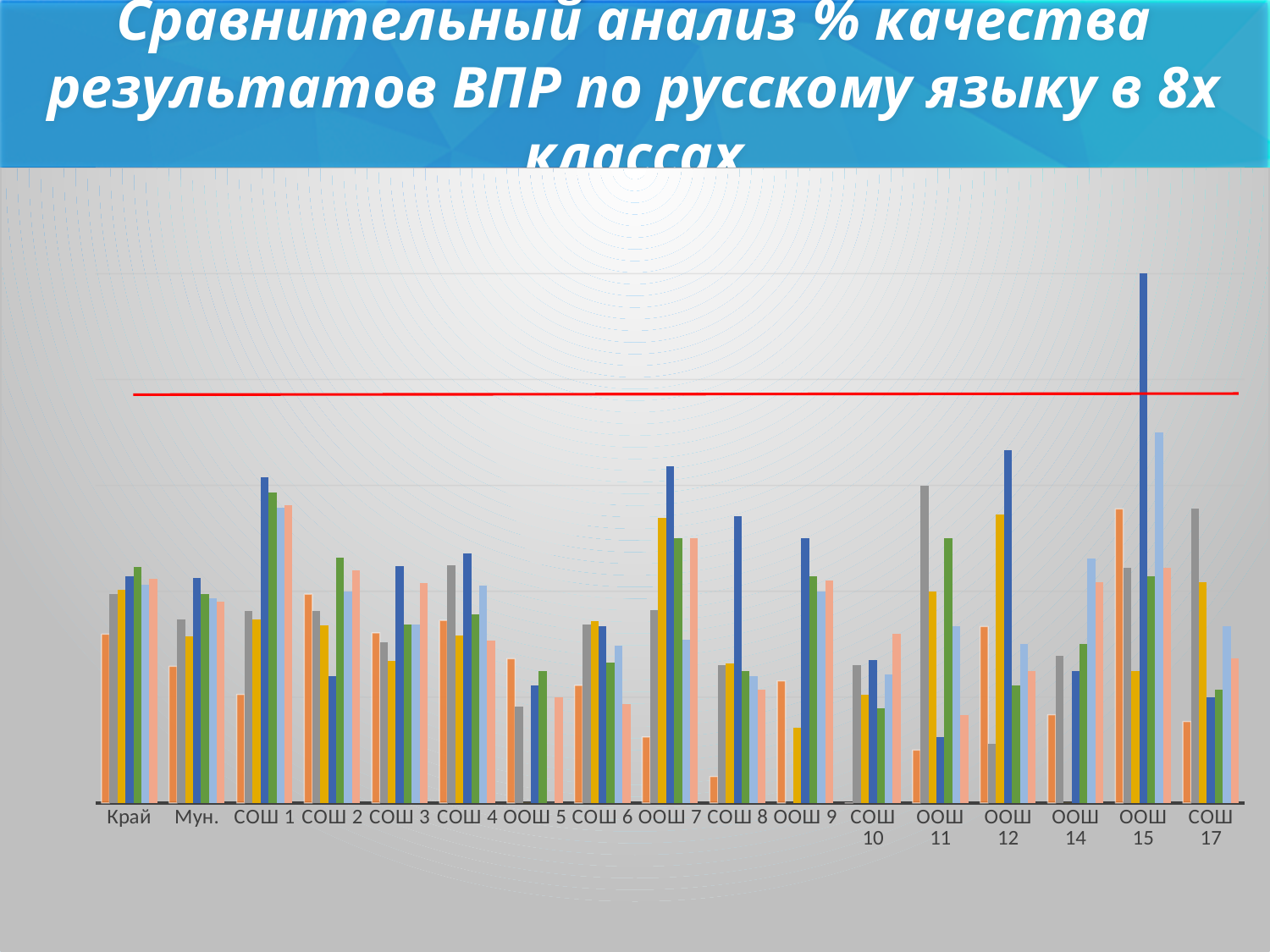
Which category has a taller tallest bar: ООШ 7 or СОШ 10? ООШ 7 Which category has a taller tallest bar: ООШ 12 or ООШ 5? ООШ 12 Which category has a taller tallest bar: ООШ 15 or СОШ 1? ООШ 15 Which category is the first one on the x axis? Край Which category contains the tallest bar in the chart? ООШ 15 Which category is the last one on the x axis? СОШ 17 What kind of chart is shown on the slide? Bar chart How many categories are shown along the x axis of the chart? 17